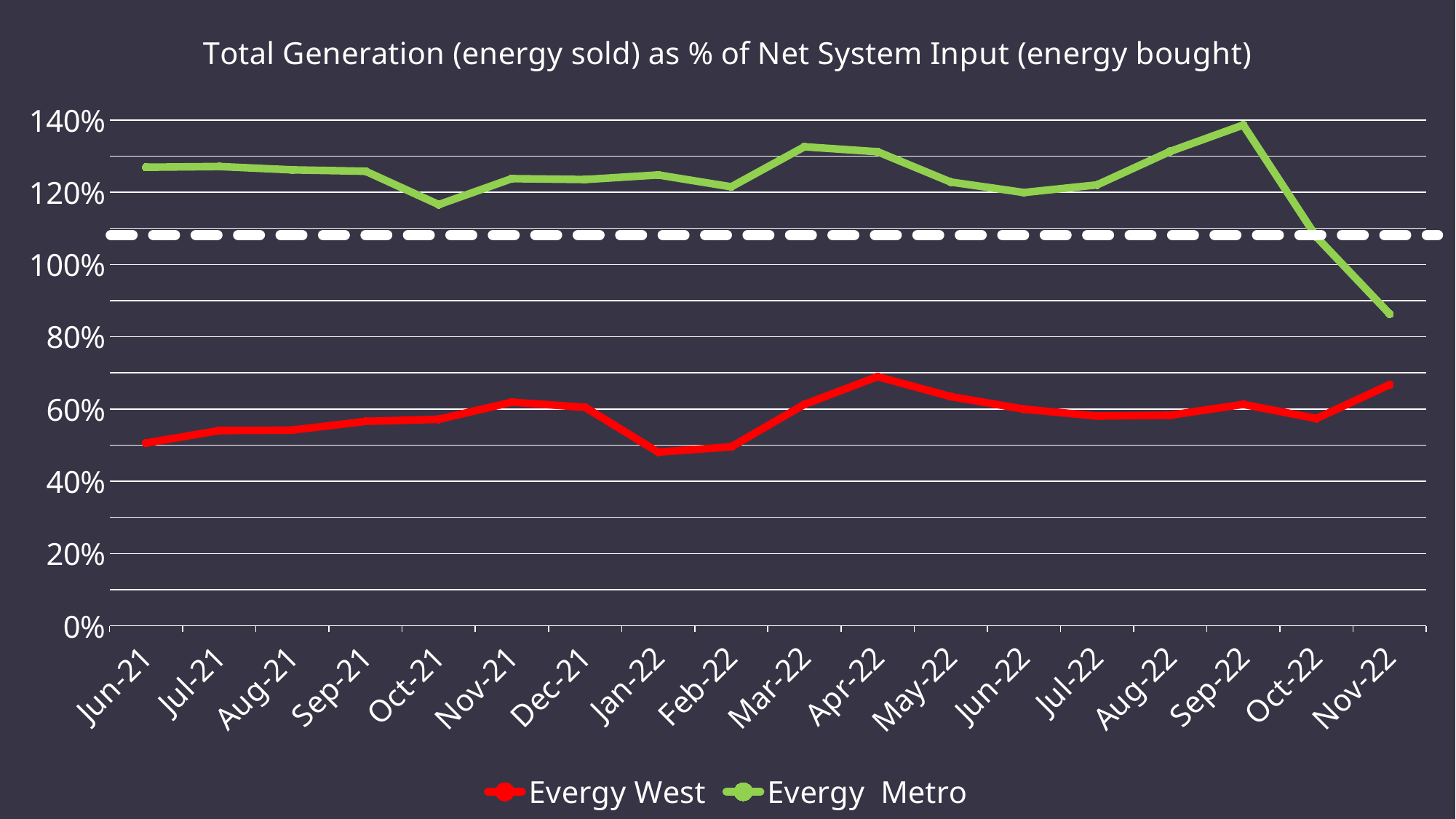
Which series is drawn in green? Evergy Metro How many series does the legend list? 2 What is the title of the chart? Total Generation (energy sold) as % of Net System Input (energy bought) What kind of chart is shown on the slide? line chart In which month does Evergy West reach its highest value? Apr-22 Is the value for Evergy Metro in Nov-22 greater or less than 100%? less In which month does Evergy Metro reach its highest value? Sep-22 In which month does Evergy West reach its lowest value? Jan-22 Which series has the larger value in Jun-21, Evergy West or Evergy Metro? Evergy Metro Is the value for Evergy West in Apr-22 greater or less than 60%? greater In which month does Evergy Metro reach its lowest value? Nov-22 How many months are plotted along the x axis? 18